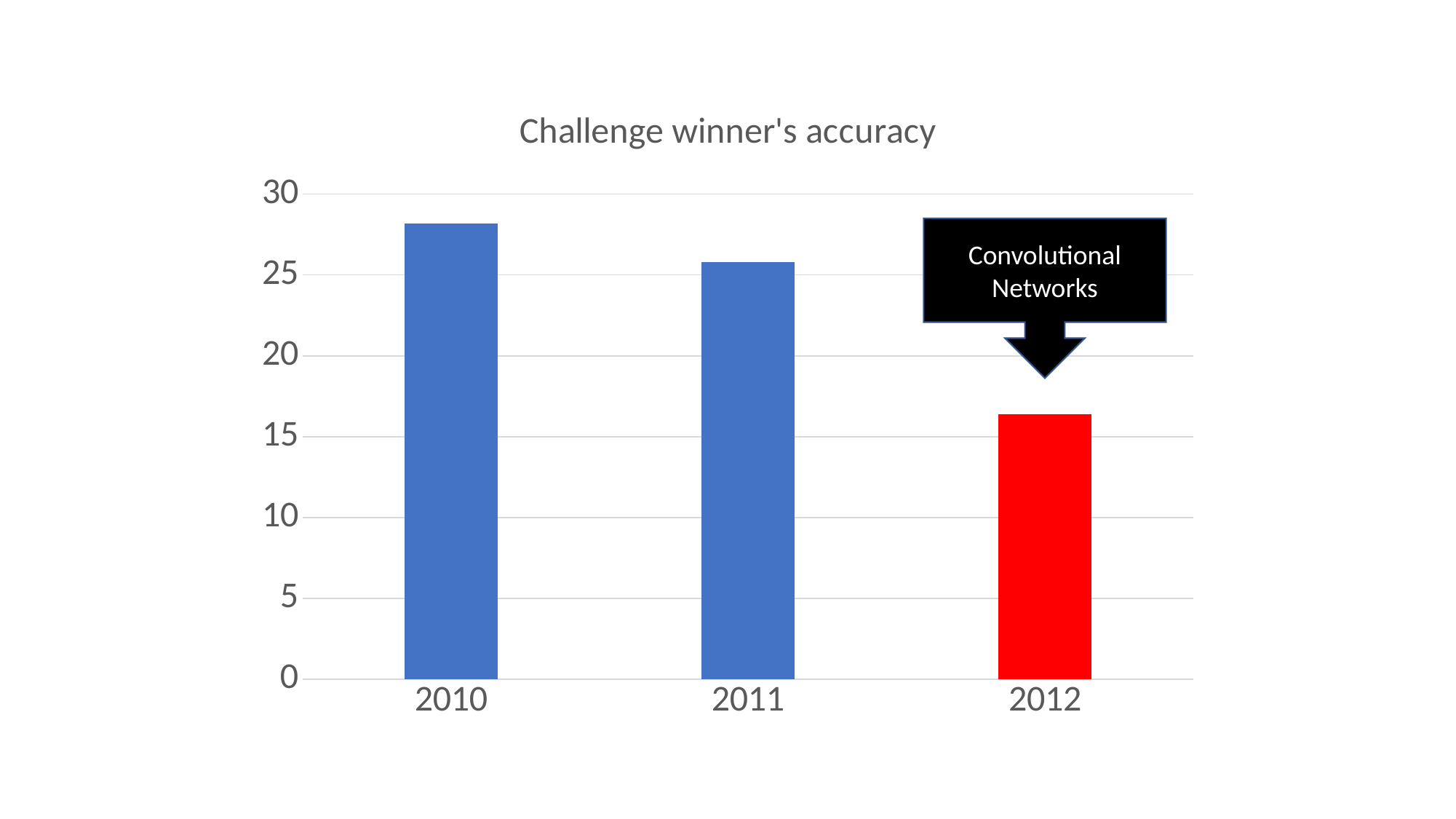
How many bars are plotted in the chart? 3 Is the value for 2012 greater or less than 20? less Is the value for 2010 greater or less than 25? greater What kind of chart is shown on the slide? bar chart What is the title of the chart? Challenge winner's accuracy Do the values rise or fall from 2010 to 2012? fall Which year has the lowest bar? 2012 Which year has the highest bar? 2010 What does the callout label above the 2012 bar say? Convolutional Networks Is the value for 2011 greater or less than 25? greater Which is larger, the value for 2010 or the value for 2011? 2010